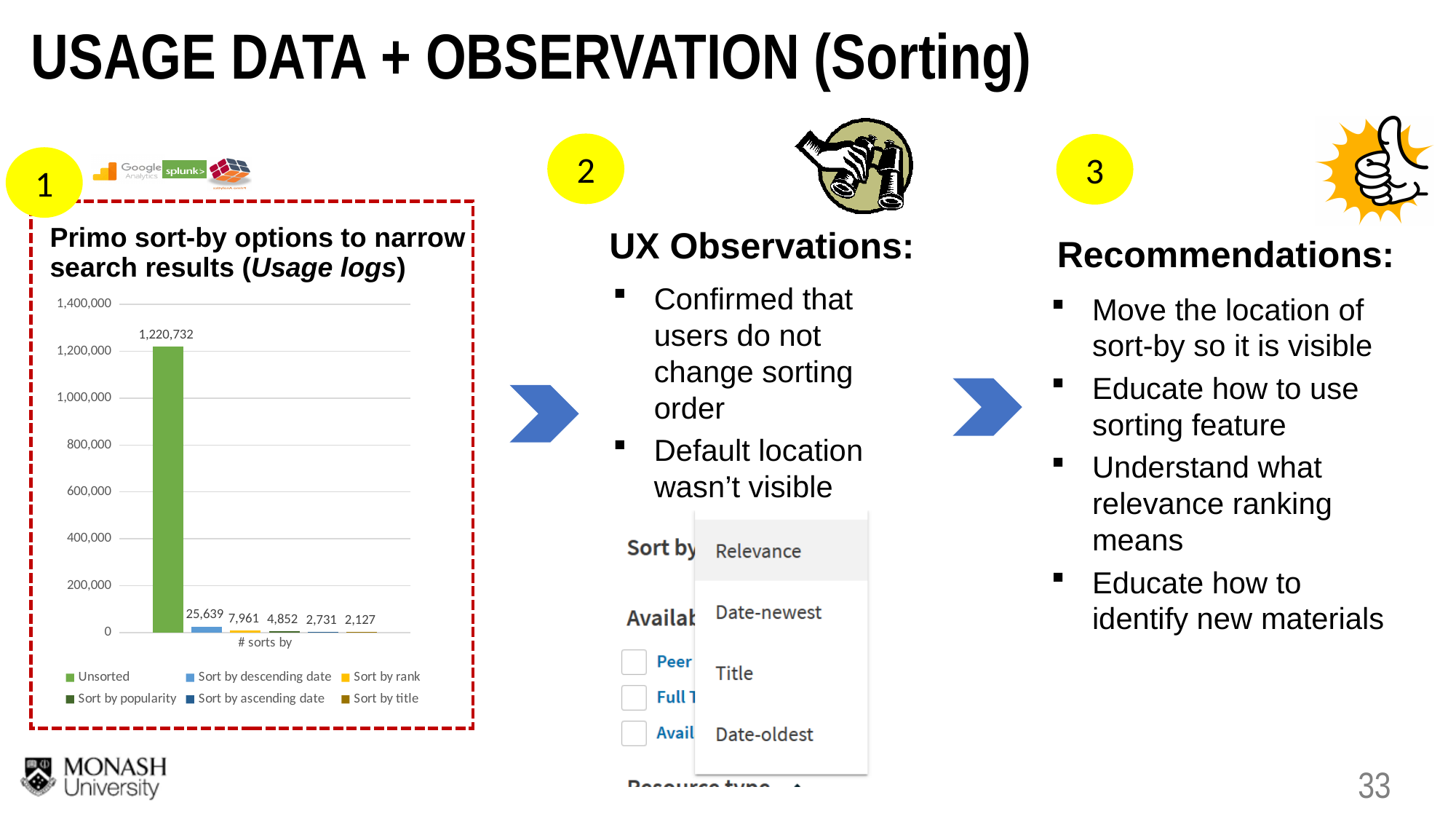
Which sort option has the lowest value in the Primo sort-by options chart? Sort by title What is the difference between Sort by descending date and Sort by ascending date in the Primo sort-by options chart? 22,908 What is the value for Sort by descending date in the Primo sort-by options chart? 25,639 What is the value for Sort by title in the Primo sort-by options chart? 2,127 How many series does the legend of the Primo sort-by options chart list? 6 What is the value for Sort by rank in the Primo sort-by options chart? 7,961 What is the x-axis label of the Primo sort-by options chart? # sorts by What is the value for Sort by popularity in the Primo sort-by options chart? 4,852 What kind of chart is shown under "Primo sort-by options to narrow search results"? bar chart Which sort option has the highest value in the Primo sort-by options chart? Unsorted What is the value for Unsorted in the Primo sort-by options chart? 1,220,732 Which is larger in the Primo sort-by options chart, Sort by rank or Sort by popularity? Sort by rank